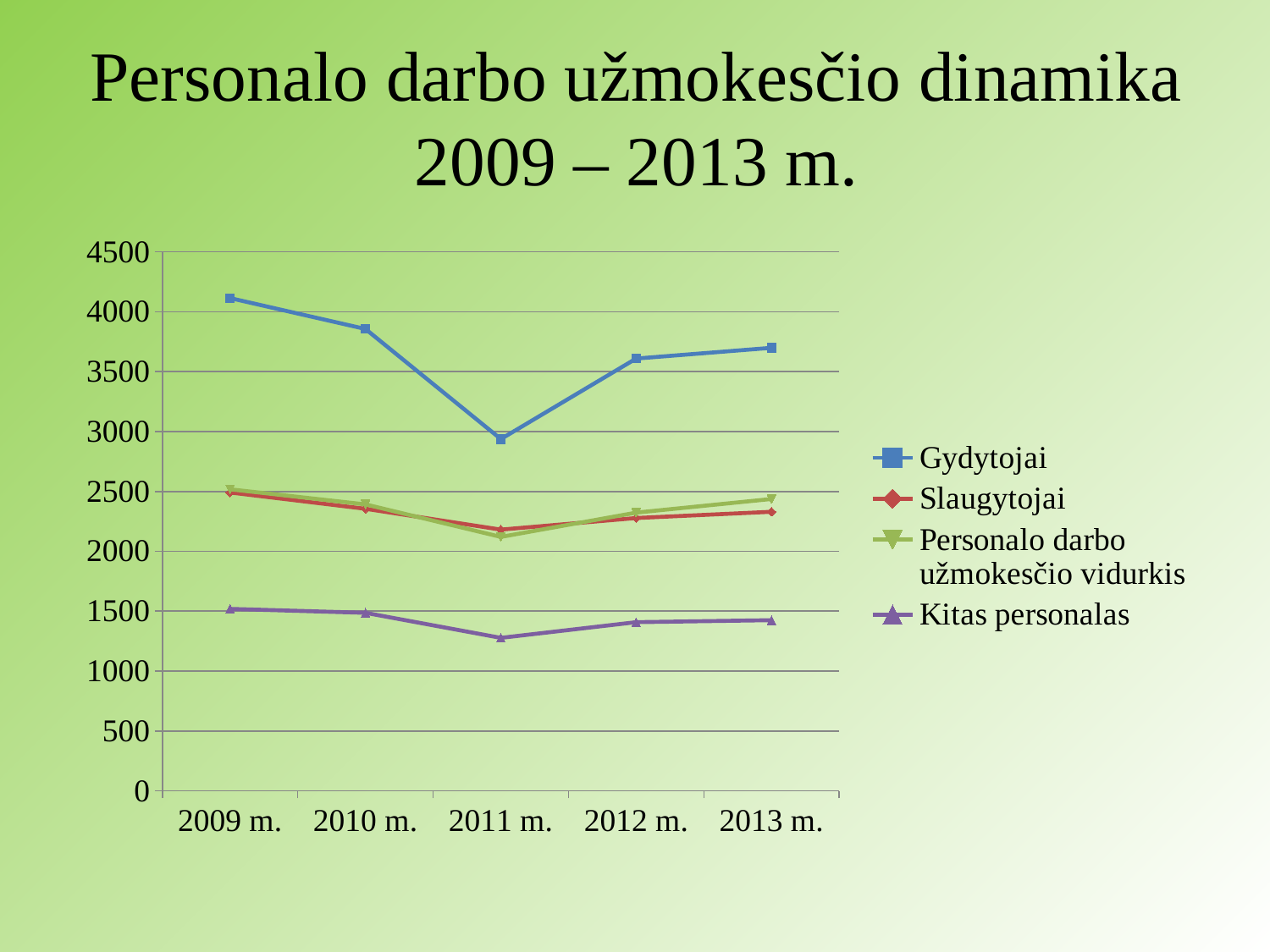
In which year is the value for Gydytojai lowest? 2011 m. In 2013 m., which series has the larger value: Gydytojai or Kitas personalas? Gydytojai Do the values for Gydytojai rise or fall from 2011 m. to 2013 m.? rise What colour is the line for Gydytojai? blue In which year is the value for Gydytojai highest? 2009 m. Is the value for Kitas personalas in 2011 m. greater or less than 1500? less How many series does the legend list? 4 In which year is the value for Kitas personalas lowest? 2011 m. What kind of chart is shown on the slide? line chart How many years are shown on the x axis? 5 Is the value for Gydytojai in 2009 m. greater or less than 4000? greater Is the value for Gydytojai in 2011 m. greater or less than 3500? less